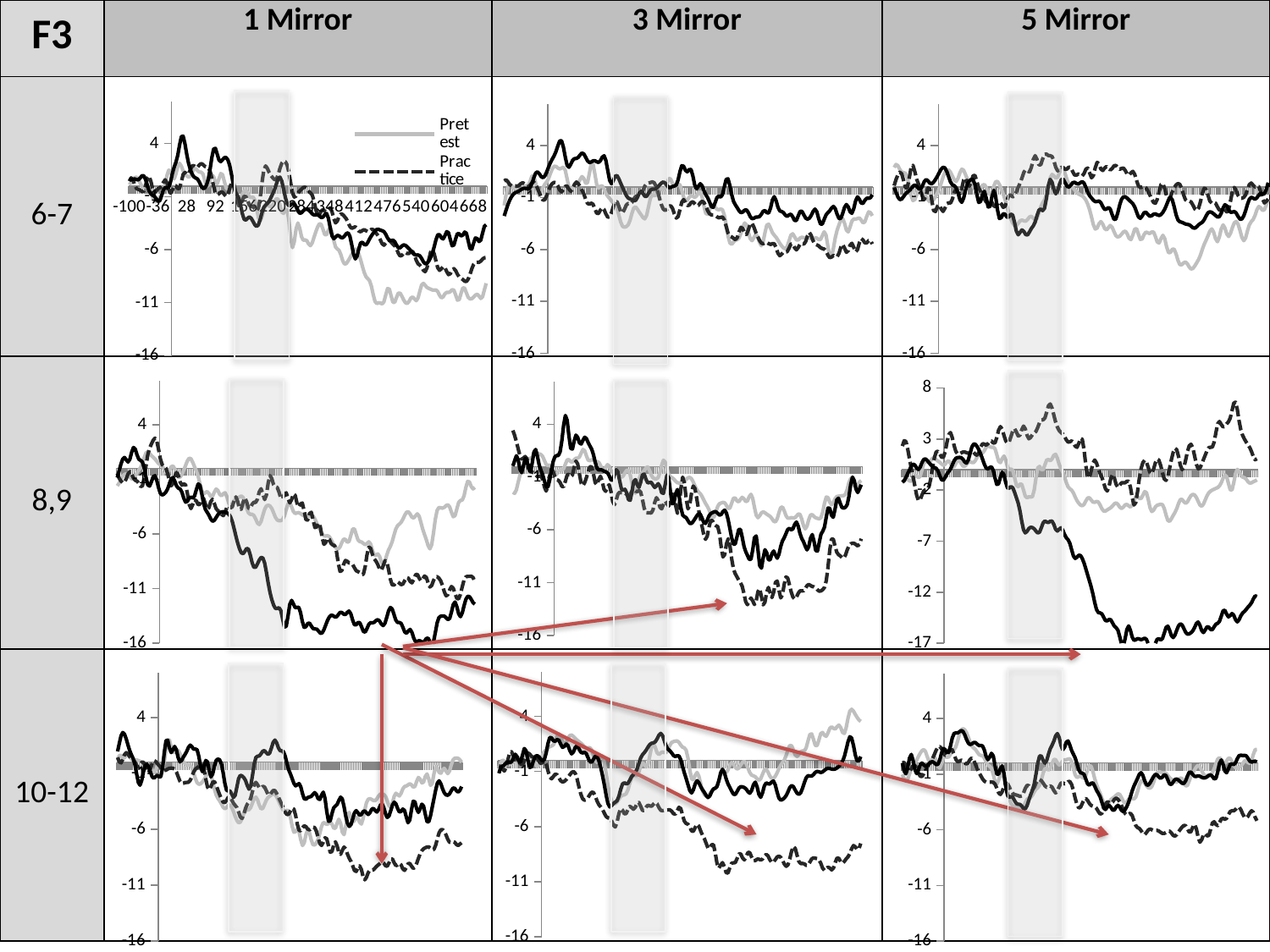
In the 8,9 / 3 Mirror chart, is the lowest value of the Practice line greater or less than -6? less Which chart uses a different y-axis scale (8 to -17) from the others? The 8,9 / 5 Mirror chart What are the three column headings above the charts? 1 Mirror, 3 Mirror, 5 Mirror In the 10-12 / 5 Mirror chart, is the lowest value of the Practice line greater or less than -11? greater In the 8,9 / 1 Mirror chart, is the lowest value of the Pretest line greater or less than -11? greater How many charts are arranged in the grid on the slide? 9 What kind of charts are shown on the slide? Line charts How many series does the legend in the 6-7 / 1 Mirror chart list? 2